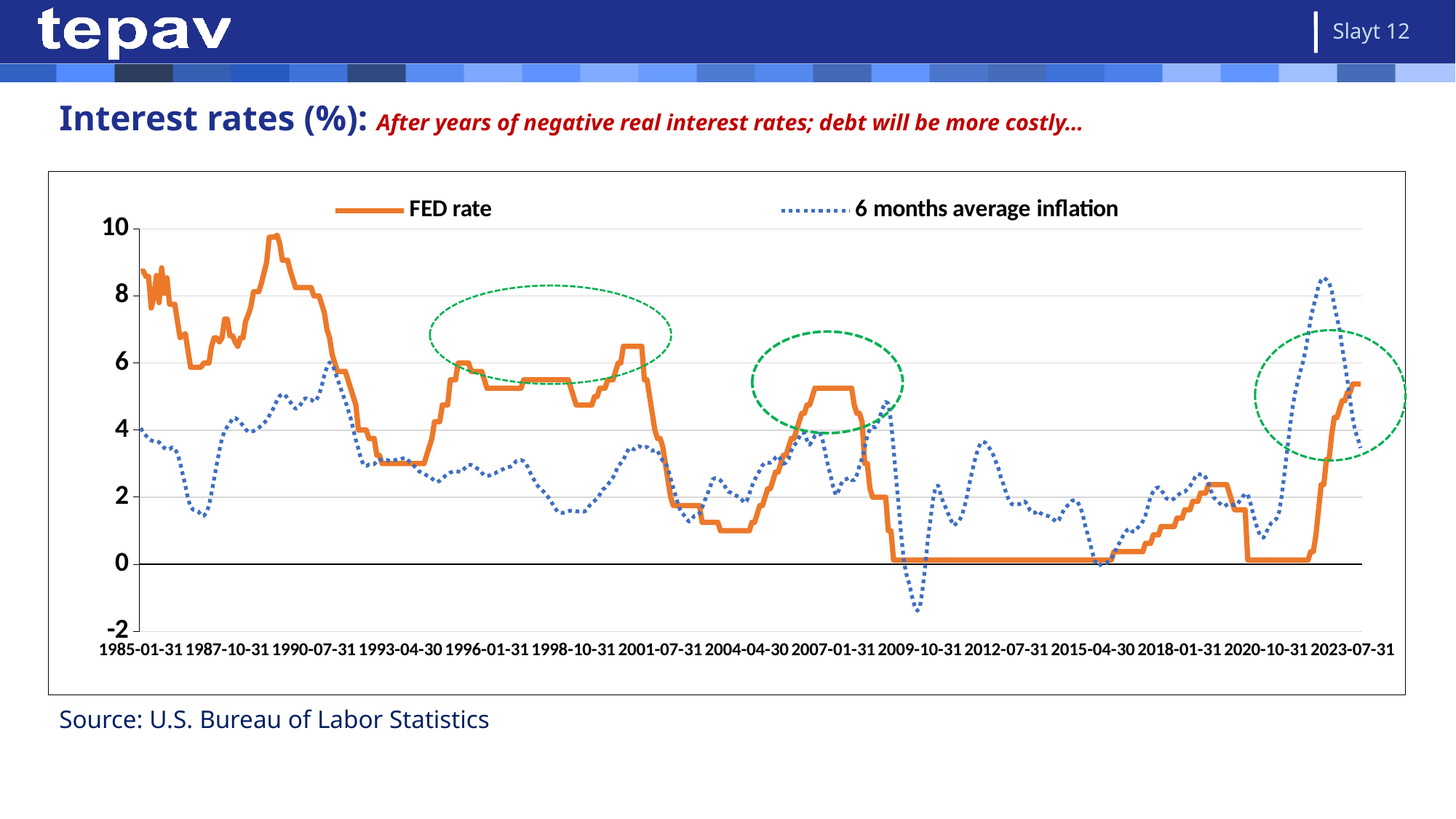
What kind of chart is shown on the slide? Line chart Is the FED rate at 2009-10-31 greater or less than 2? less What source is cited below the chart? U.S. Bureau of Labor Statistics Is the peak value of the FED rate around 1990 greater or less than 8? greater Which series reaches the highest value anywhere on the chart? FED rate Is the lowest value of the 6 months average inflation line (around 2009) greater or less than 0? less How many series does the legend list? 2 Which series reaches the lowest value anywhere on the chart? 6 months average inflation At 1985-01-31, which is larger: the FED rate or the 6 months average inflation? FED rate Does the FED rate rise or fall between 2020-10-31 and 2023-07-31? rise Which two series are listed in the chart legend? FED rate and 6 months average inflation